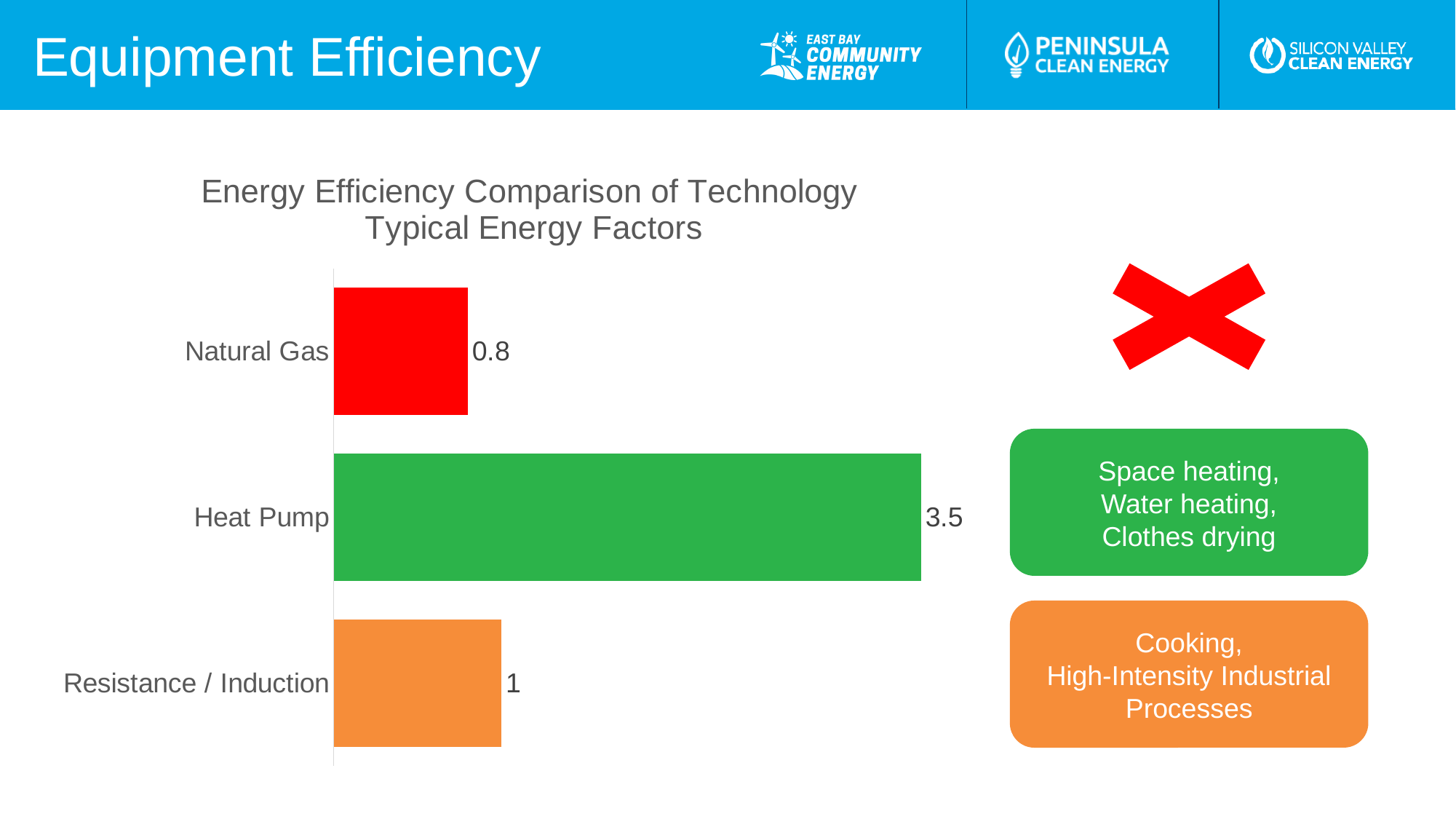
Which technology has the highest typical energy factor? Heat Pump What is the difference between the energy factors of Resistance / Induction and Natural Gas? 0.2 Which has a larger energy factor, Heat Pump or Resistance / Induction? Heat Pump What colour is the Heat Pump bar? Green What is the typical energy factor for Heat Pump? 3.5 How many technologies are shown in the chart? 3 What is the typical energy factor for Natural Gas? 0.8 What is the title of the chart? Energy Efficiency Comparison of Technology Typical Energy Factors What is the difference between the energy factors of Heat Pump and Natural Gas? 2.7 Which technology has the lowest typical energy factor? Natural Gas What kind of chart is shown on the slide? Bar chart What is the typical energy factor for Resistance / Induction? 1